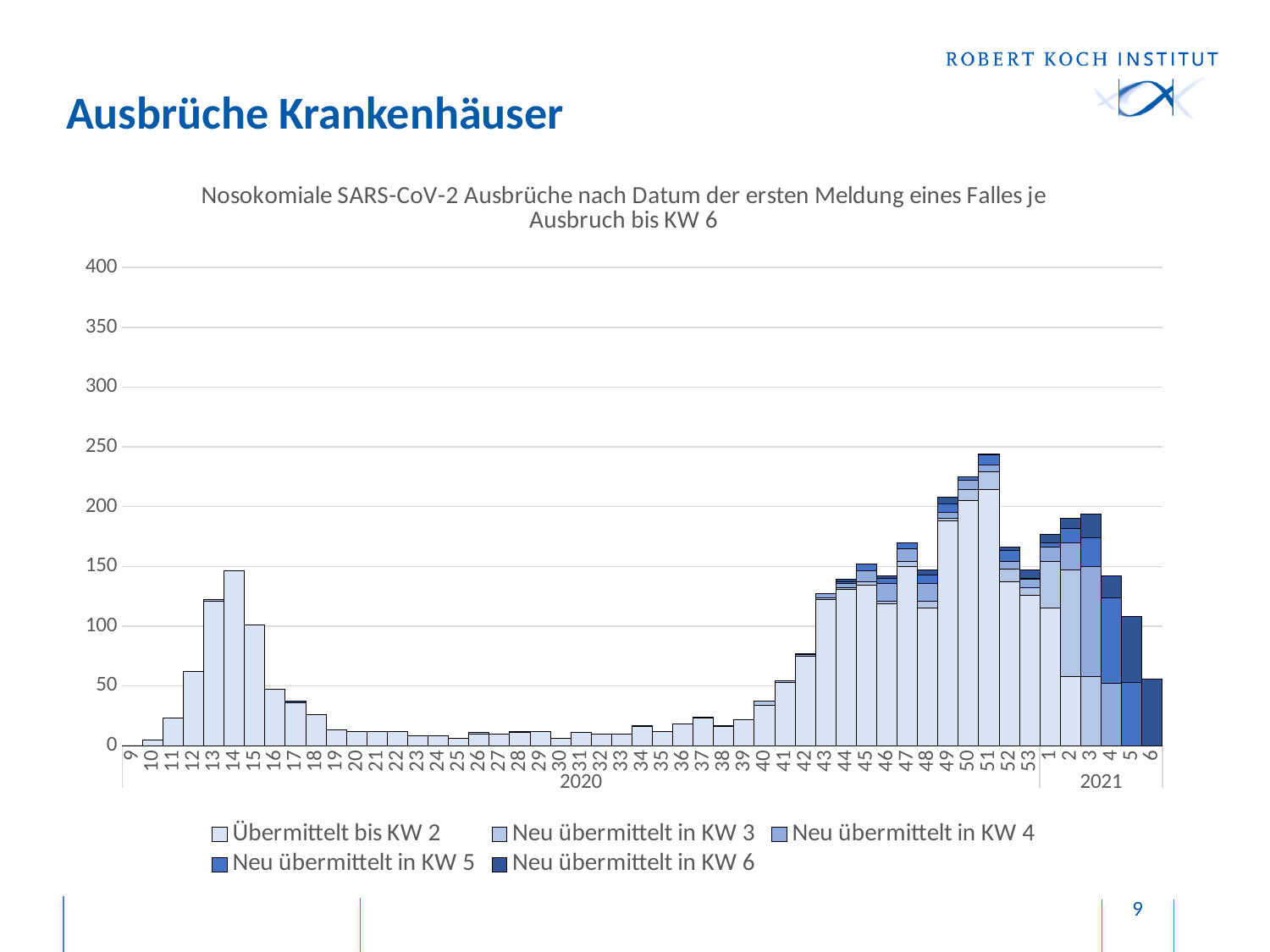
Is the total value for KW 40 of 2020 greater or less than 50? less Is the total value for KW 14 of 2020 greater or less than 100? greater Which bar is taller, KW 13 of 2020 or KW 14 of 2020? KW 14 of 2020 Do the totals rise or fall from KW 14 to KW 19 of 2020? fall Which bar is taller, KW 3 of 2021 or KW 6 of 2021? KW 3 of 2021 What kind of chart is shown on the slide? Stacked bar chart Which calendar week has the highest total number of outbreaks? KW 51 (2020) What is the first series listed in the legend? Übermittelt bis KW 2 Do the totals rise or fall from KW 40 to KW 51 of 2020? rise Is the total value for KW 6 of 2021 greater or less than 100? less How many series does the legend list? 5